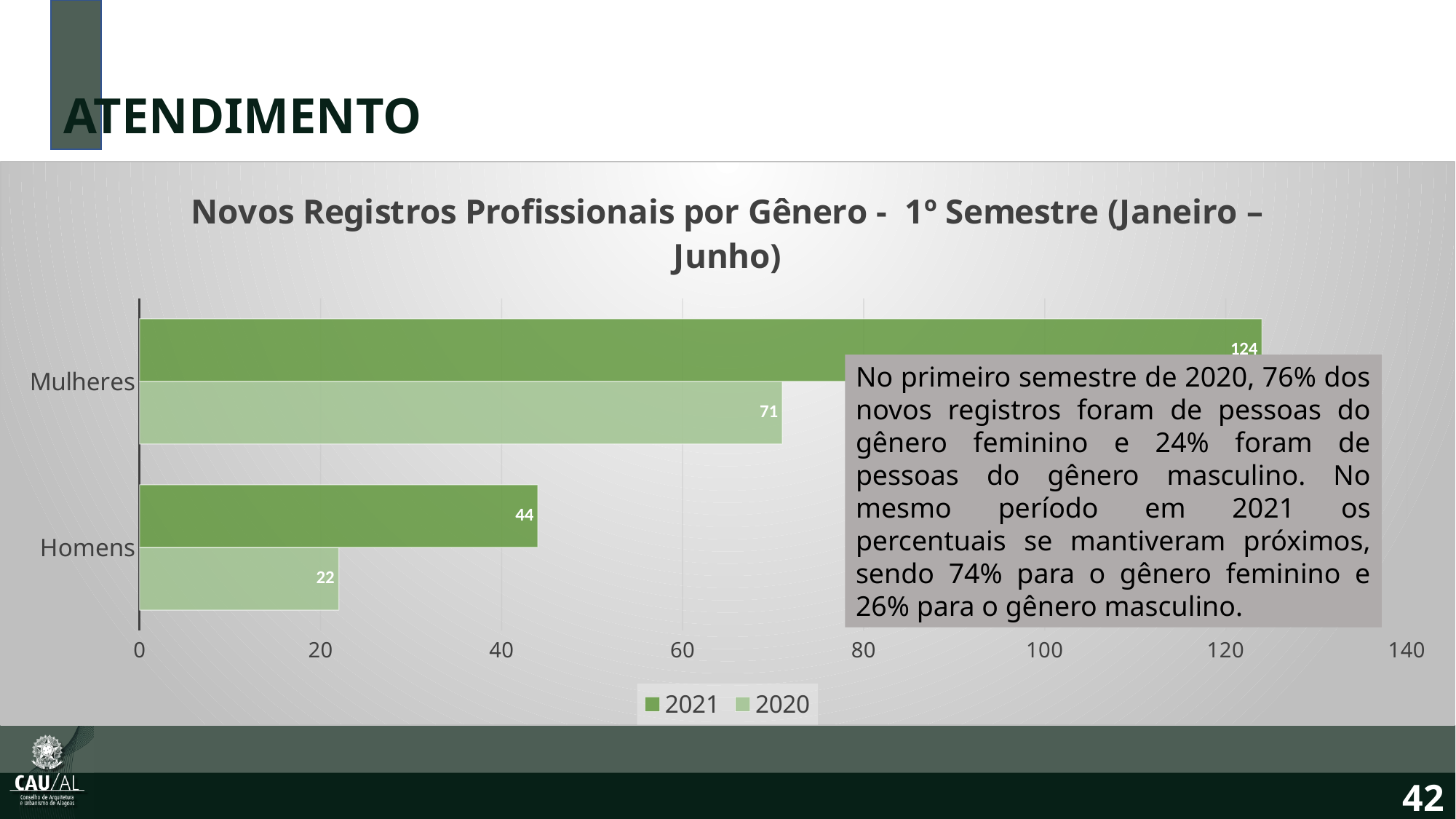
Which category has the lowest value in the 2020 series? Homens What is the value for Homens in the 2021 series? 44 What is the difference between the 2021 and 2020 values for Mulheres? 53 What kind of chart is shown on the slide? Bar chart How many series does the legend list? 2 Which is larger: the 2021 value for Homens or the 2020 value for Mulheres? 2020 value for Mulheres What is the value for Mulheres in the 2020 series? 71 What is the difference between the 2021 and 2020 values for Homens? 22 How many categories are shown on the chart? 2 What is the value for Mulheres in the 2021 series? 124 Which category has the highest value in the 2021 series? Mulheres What is the value for Homens in the 2020 series? 22